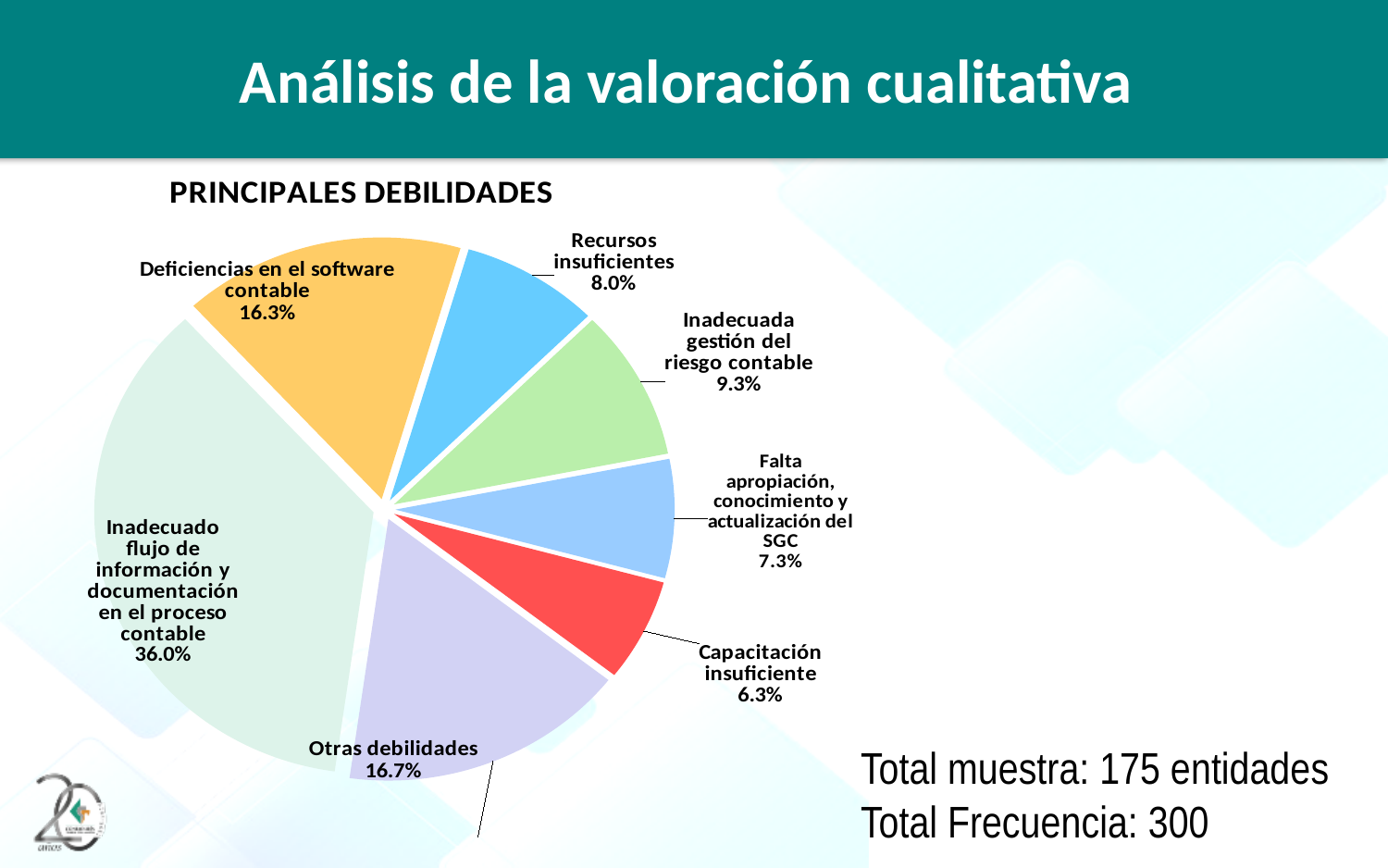
What is the difference in percentage points between 'Inadecuado flujo de información y documentación en el proceso contable' and 'Otras debilidades'? 19.3 What percentage is shown for 'Capacitación insuficiente'? 6.3% How many slices does the pie chart have? 7 What is the difference in percentage points between 'Otras debilidades' and 'Deficiencias en el software contable'? 0.4 What percentage is shown for 'Recursos insuficientes'? 8.0% What is the title of the chart? PRINCIPALES DEBILIDADES What percentage is shown for 'Inadecuada gestión del riesgo contable'? 9.3% What type of chart is shown on the slide? pie chart Which is larger: 'Inadecuada gestión del riesgo contable' or 'Falta apropiación, conocimiento y actualización del SGC'? Inadecuada gestión del riesgo contable Which category has the largest slice of the pie? Inadecuado flujo de información y documentación en el proceso contable Which category has the smallest slice of the pie? Capacitación insuficiente What percentage is shown for 'Deficiencias en el software contable'? 16.3%